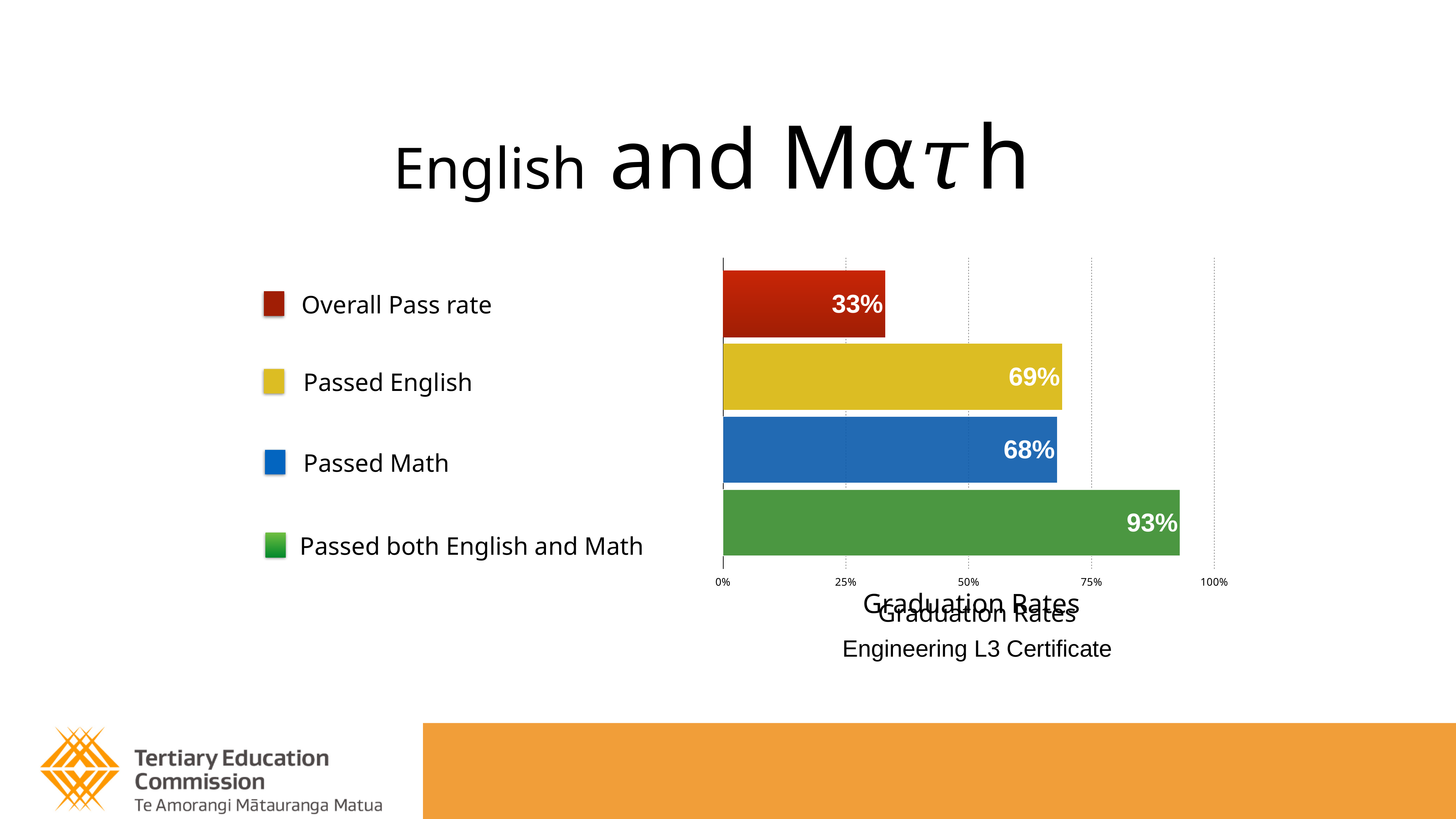
What is the graduation rate for students who passed Math? 68% Which category has the lowest graduation rate? Overall Pass rate Which category has the highest graduation rate? Passed both English and Math How many bars are shown on the chart? 4 What is the graduation rate for students who passed both English and Math? 93% Is the Overall Pass rate greater or less than 50%? less What is the graduation rate for students who passed English? 69% What kind of chart is shown on the slide? bar chart Which is larger, the graduation rate for Passed both English and Math or for Passed English? Passed both English and Math What is the difference between the graduation rates for Passed English and Passed Math? 1% What is the Overall Pass rate shown on the chart? 33% What is the difference between the graduation rate for Passed both English and Math and the Overall Pass rate? 60%